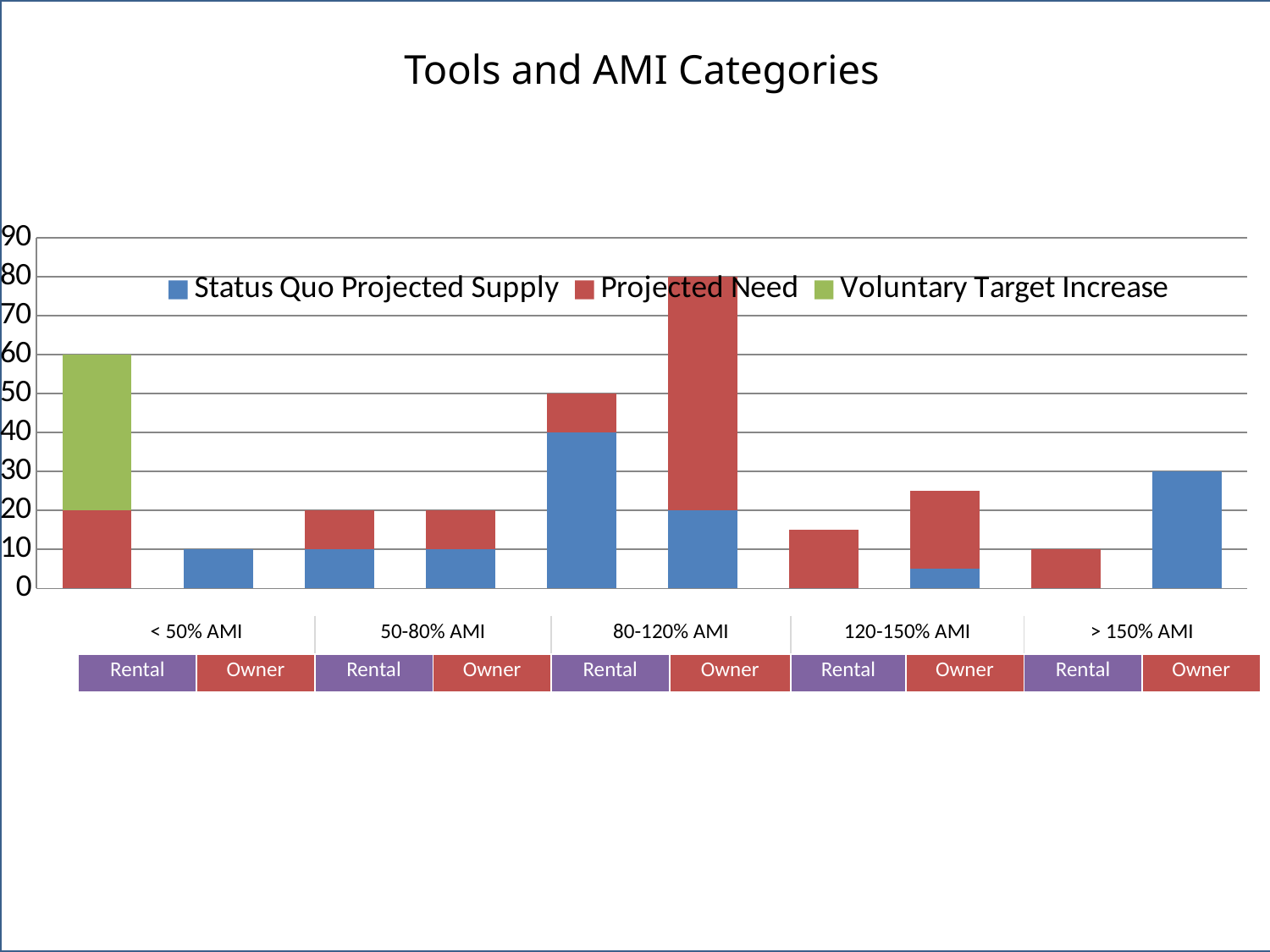
What kind of chart is shown on the slide? bar chart Is the total for 120-150% AMI Owner greater or less than 20? greater What is the total height of the 80-120% AMI Owner bar? 80 How many series does the legend list? 3 Is the value for 120-150% AMI Rental greater or less than 20? less What is the difference between the total for 80-120% AMI Owner and the total for < 50% AMI Rental? 20 How many bars are plotted in the chart? 10 Which bar is taller: 80-120% AMI Rental or > 150% AMI Owner? 80-120% AMI Rental What is the total height of the < 50% AMI Rental bar? 60 Which series is shown in green in the legend? Voluntary Target Increase Which bar is the tallest in the chart? 80-120% AMI Owner What is the value of the > 150% AMI Owner bar? 30